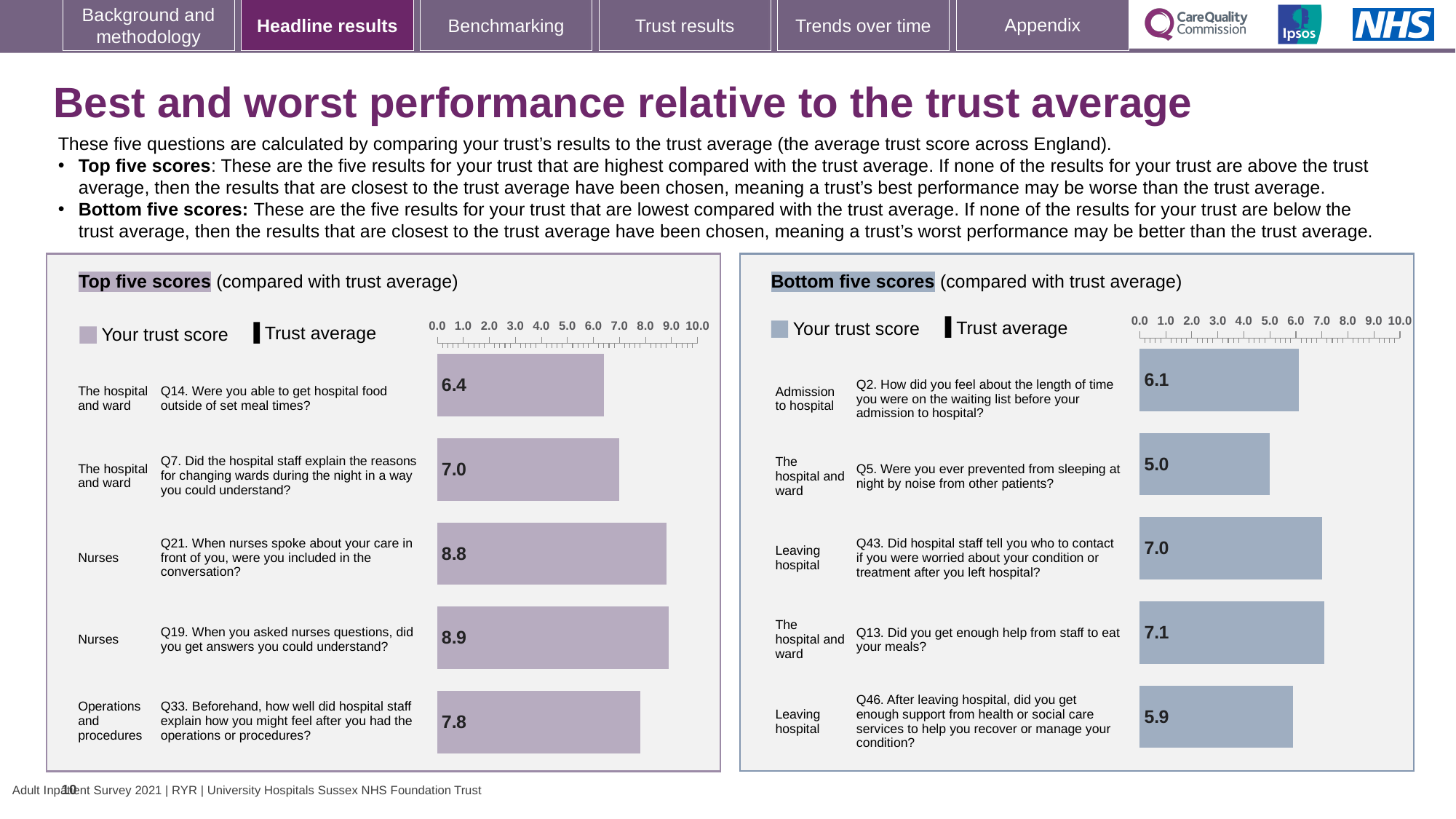
In the Top five scores chart, which has the larger score: Q7 or Q33? Q33 In the Bottom five scores chart, what is the trust score for Q46 about support from health or social care services after leaving hospital? 5.9 In the Top five scores chart, what is the trust score for Q33 about explaining how you might feel after operations or procedures? 7.8 In the Top five scores chart, which question has the highest trust score? Q19 What type of chart is the Top five scores chart? Bar chart In the Bottom five scores chart, what is the trust score for Q5 (Were you ever prevented from sleeping at night by noise from other patients?)? 5.0 In the Bottom five scores chart, what is the difference between the scores for Q13 and Q2? 1.0 In the Top five scores chart, which question has the lowest trust score? Q14 In the Bottom five scores chart, which question has the lowest trust score? Q5 How many questions are shown in the Bottom five scores chart? 5 What two items does the legend of the Bottom five scores chart list? Your trust score and Trust average In the Top five scores chart, what is the trust score for Q14 (Were you able to get hospital food outside of set meal times?)? 6.4